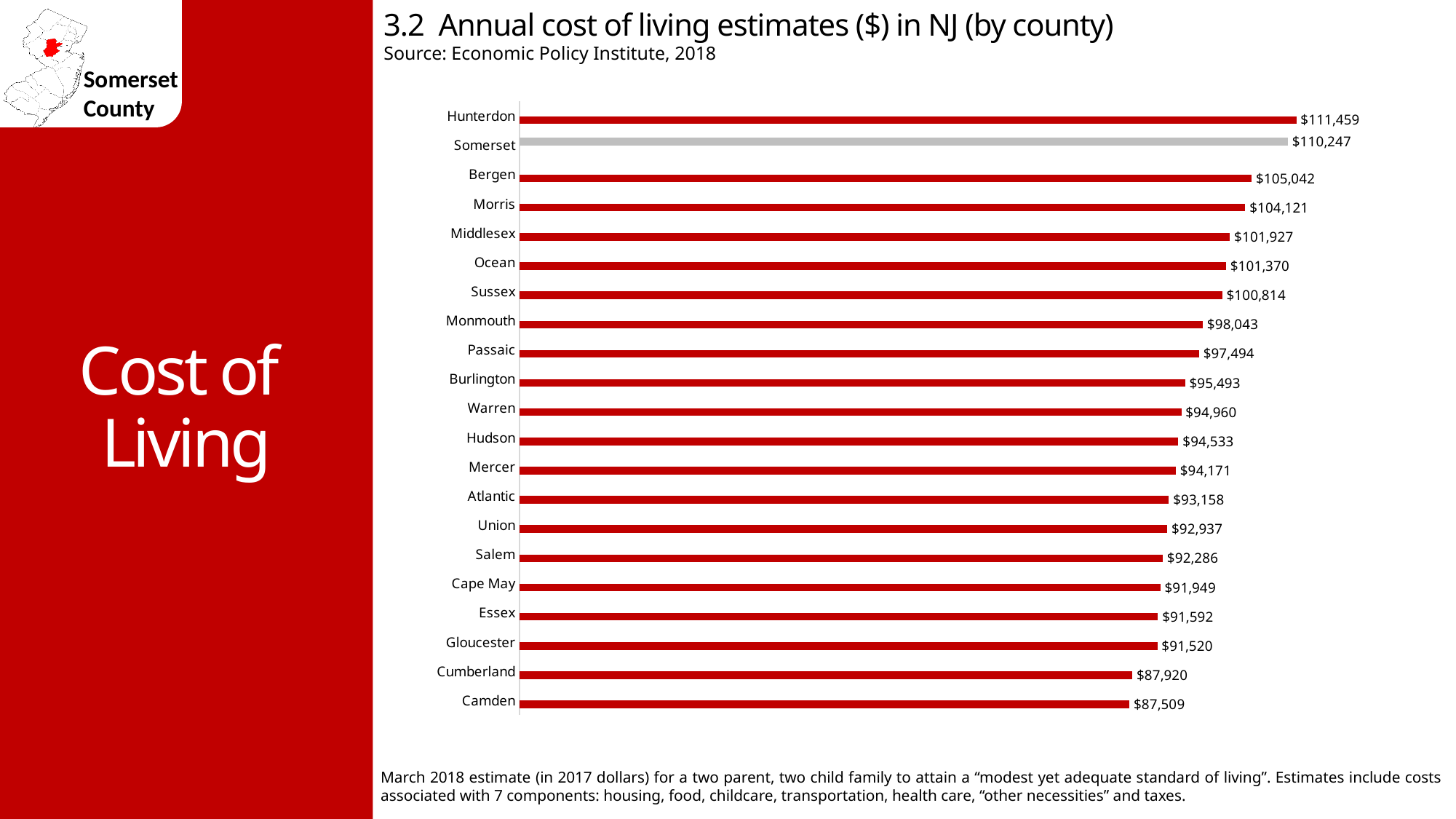
What is the difference between the cost of living estimates for Hunterdon and Somerset? $1,212 Which county's bar is shown in grey instead of red? Somerset What is the difference between the cost of living estimates for Bergen and Camden? $17,533 What is the annual cost of living estimate for Somerset county? $110,247 What is the annual cost of living estimate for Monmouth county? $98,043 Which county has a higher cost of living estimate, Morris or Middlesex? Morris What type of chart is used to show the cost of living estimates? Bar chart Which county has a higher cost of living estimate, Cumberland or Gloucester? Gloucester Which county has the highest annual cost of living estimate? Hunterdon How many counties are shown in the chart? 21 Which county has the lowest annual cost of living estimate? Camden What is the annual cost of living estimate for Cape May county? $91,949